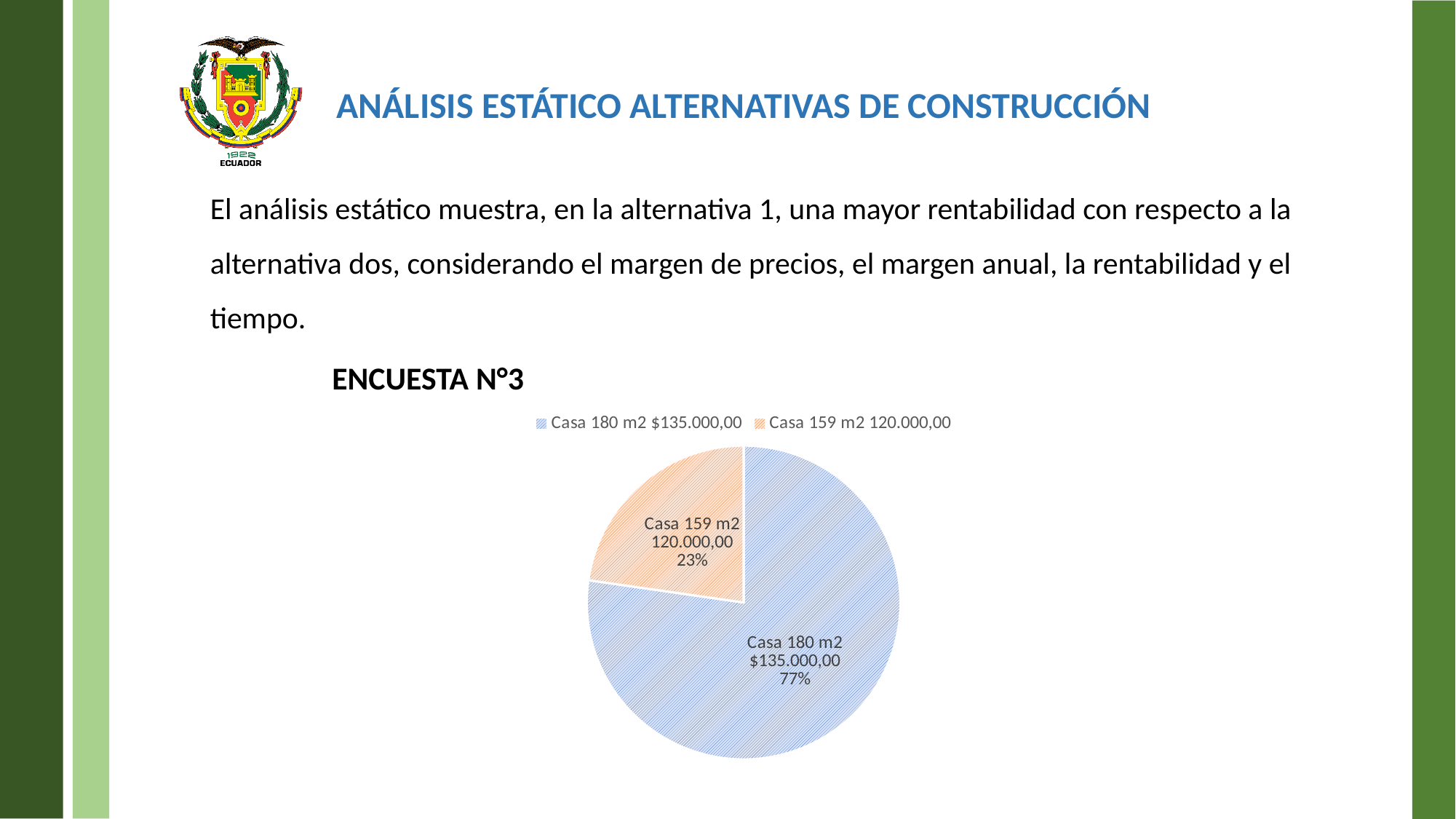
Which slice of the pie is the largest? Casa 180 m2 $135.000,00 Which slice is larger: 'Casa 180 m2 $135.000,00' or 'Casa 159 m2 120.000,00'? Casa 180 m2 $135.000,00 What colour is the slice for 'Casa 159 m2 120.000,00'? orange What kind of chart is shown on the slide? pie chart What is the difference in percentage points between the 'Casa 180 m2 $135.000,00' slice and the 'Casa 159 m2 120.000,00' slice? 54 percentage points How many slices does the pie chart have? 2 What is the title shown above the pie chart? ENCUESTA N°3 What share of the pie does the slice 'Casa 159 m2 120.000,00' represent? 23% Which slice of the pie is the smallest? Casa 159 m2 120.000,00 What share of the pie does the slice 'Casa 180 m2 $135.000,00' represent? 77% How many entries does the legend list? 2